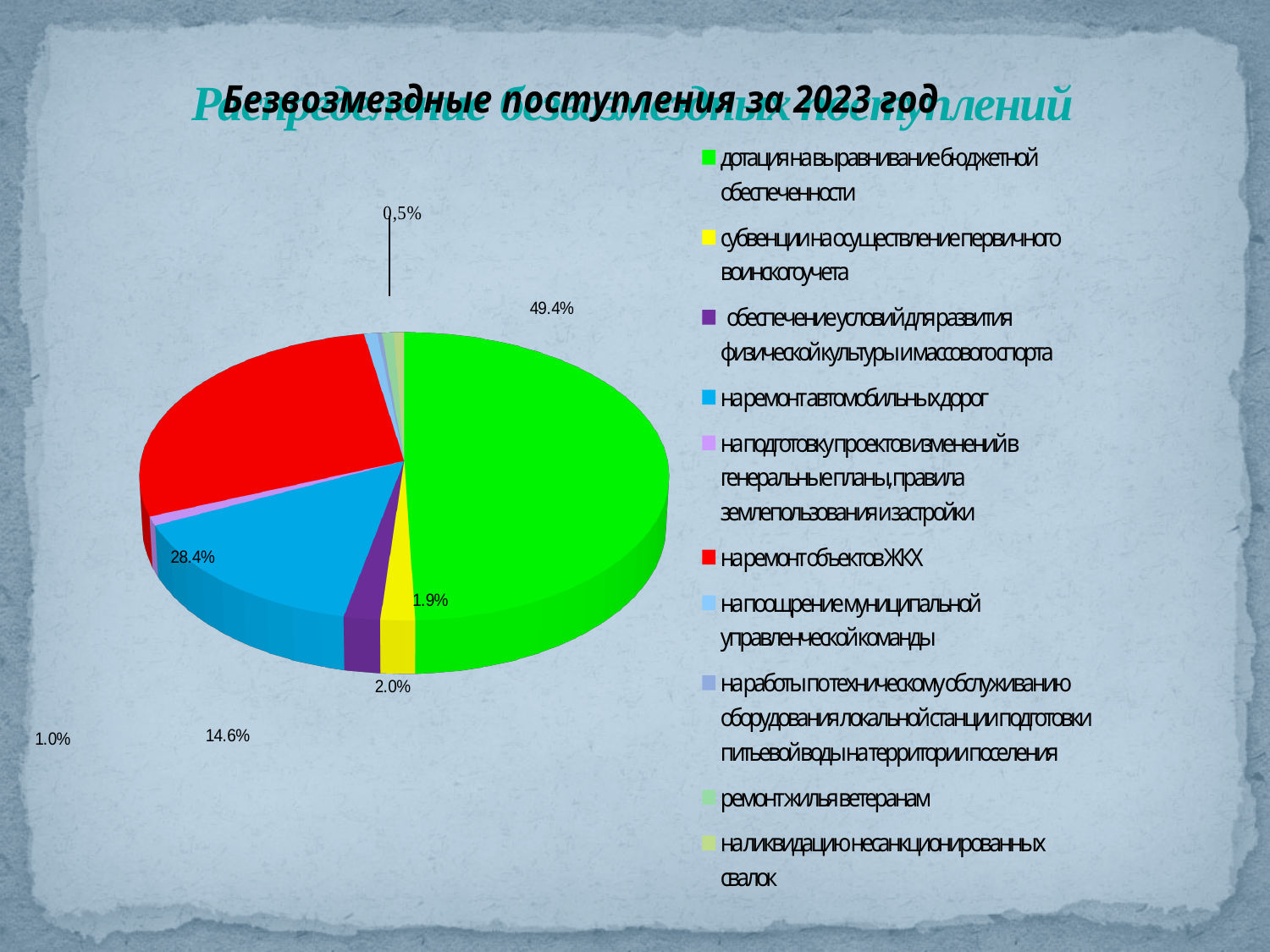
What share of the pie is labelled for 'на ремонт автомобильных дорог'? 14.6% What share of the pie is labelled for 'на ремонт объектов ЖКХ'? 28.4% What colour is the slice for 'на ремонт объектов ЖКХ'? Red What is the difference between the share for 'дотация на выравнивание бюджетной обеспеченности' and the share for 'на ремонт объектов ЖКХ'? 21.0% Which category has the largest share of the pie? дотация на выравнивание бюджетной обеспеченности What share of the pie is labelled for 'обеспечение условий для развития физической культуры и массового спорта'? 2.0% What kind of chart is shown on the slide? Pie chart What share of the pie is labelled for 'дотация на выравнивание бюджетной обеспеченности'? 49.4% How many categories does the legend list? 10 What share of the pie is labelled for 'субвенции на осуществление первичного воинского учета'? 1.9% Which is larger: the share for 'на ремонт автомобильных дорог' or the share for 'на ремонт объектов ЖКХ'? на ремонт объектов ЖКХ What is the difference between the share for 'на ремонт объектов ЖКХ' and the share for 'на ремонт автомобильных дорог'? 13.8%